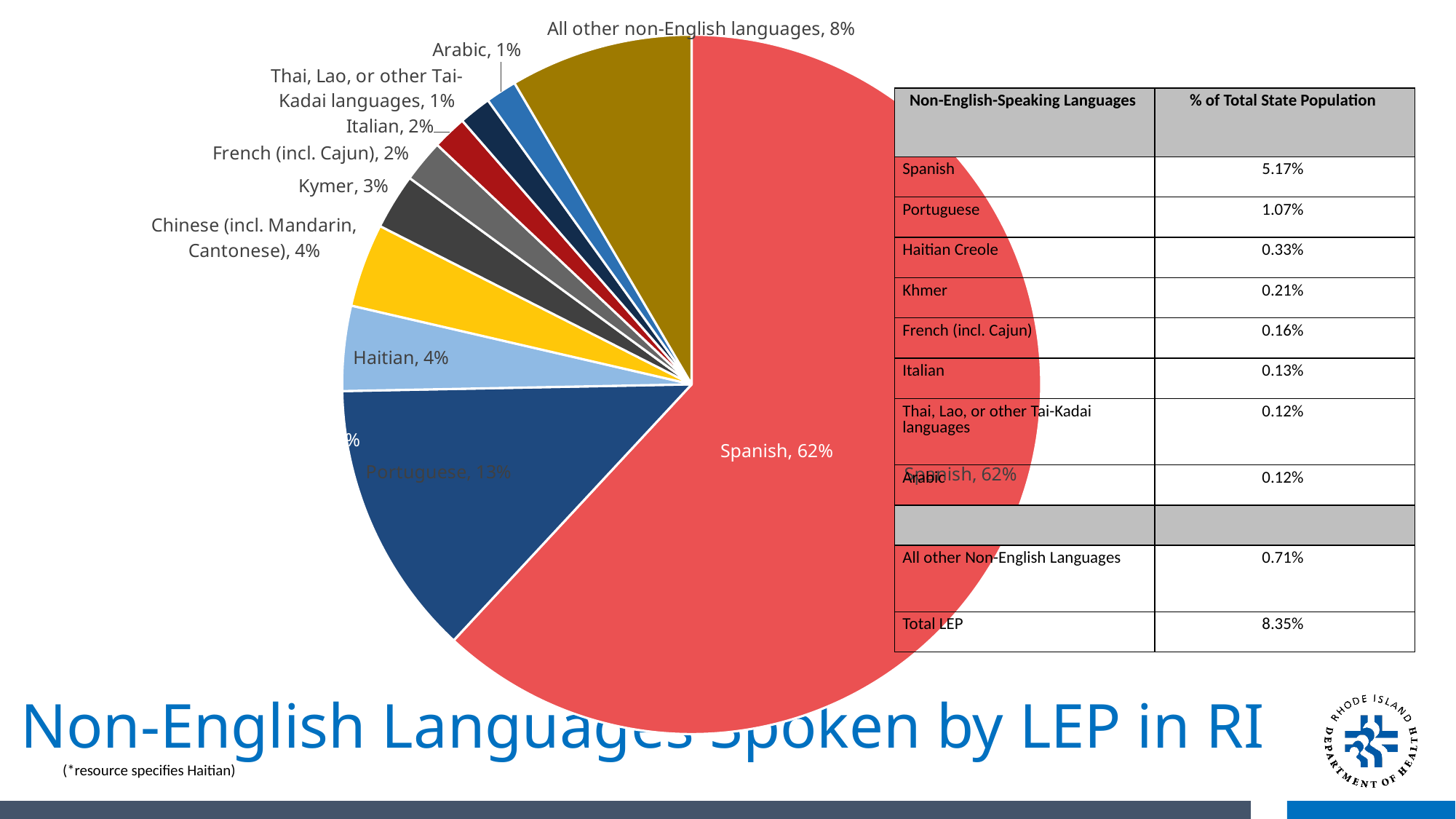
Which language has the largest slice of the pie chart? Spanish What is the value shown for Portuguese in the pie chart? 13% What share of the pie does Spanish account for? 62% Which slice is larger, Haitian or Kymer? Haitian What is the value shown for All other non-English languages in the pie chart? 8% How many slices does the pie chart have? 10 What kind of chart is shown on the slide? pie chart What is the difference in percentage points between the Spanish and Portuguese slices? 49 What is the value shown for Kymer in the pie chart? 3% What is the value shown for Chinese (incl. Mandarin, Cantonese) in the pie chart? 4% What is the title of the slide containing the pie chart? Non-English Languages Spoken by LEP in RI What is the value shown for Haitian in the pie chart? 4%